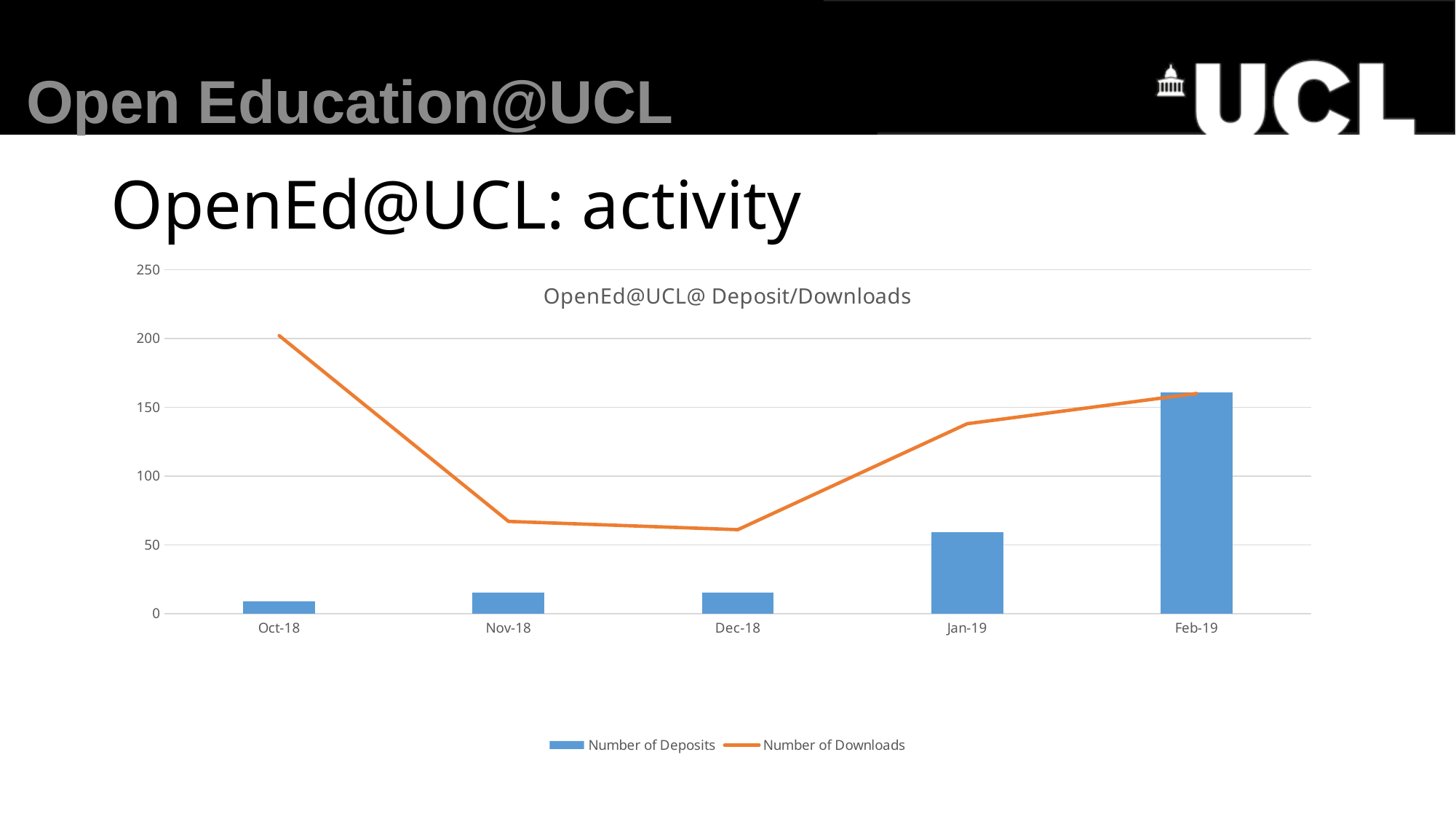
What is the title of the chart? OpenEd@UCL@ Deposit/Downloads What kind of chart is this? Combination bar and line chart In which month is the Number of Deposits highest? Feb-19 Is the Number of Downloads for Oct-18 greater or less than 150? greater In which month is the Number of Deposits lowest? Oct-18 Is the Number of Downloads for Nov-18 greater or less than 100? less How many series does the legend list? 2 In which month is the Number of Downloads highest? Oct-18 Does the Number of Deposits rise or fall from Oct-18 to Feb-19? rise Is the Number of Deposits for Jan-19 greater or less than 100? less How many months are shown on the x axis? 5 Which series is drawn as an orange line? Number of Downloads